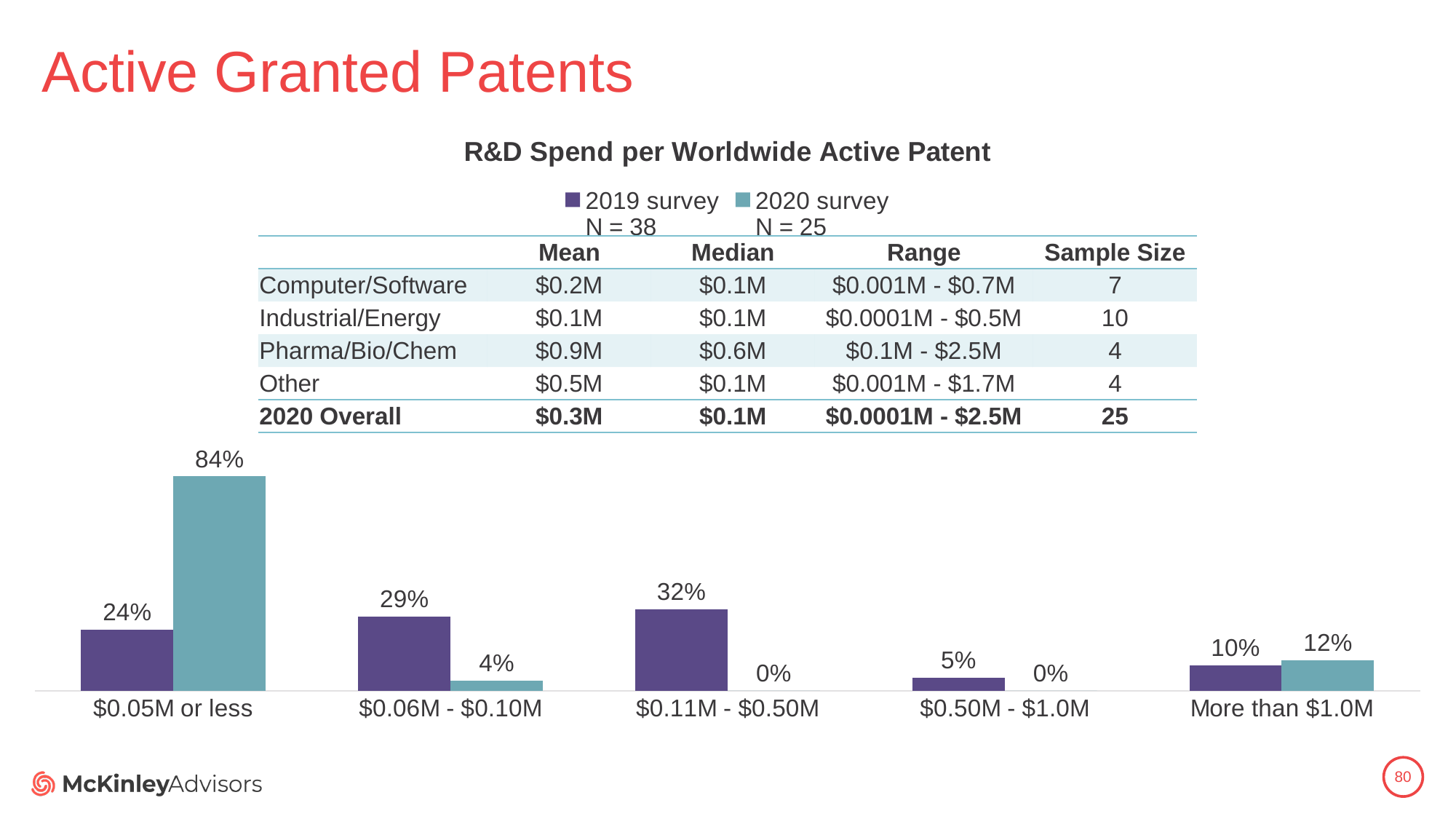
What is the 2020 survey value for the "More than $1.0M" category? 12% Which is larger for the "$0.06M - $0.10M" category: the 2019 survey value or the 2020 survey value? 2019 survey What is the title of the chart? R&D Spend per Worldwide Active Patent Which category has the highest 2019 survey value? $0.11M - $0.50M How many categories are shown on the x axis of the chart? 5 What is the difference between the 2020 survey and 2019 survey values for the "$0.05M or less" category? 60% What is the 2020 survey value for the "$0.05M or less" category? 84% What is the 2019 survey value for the "$0.11M - $0.50M" category? 32% What is the 2019 survey value for the "$0.50M - $1.0M" category? 5% What type of chart is shown on the slide? Bar chart Which category has the lowest 2019 survey value? $0.50M - $1.0M How many series does the chart legend list? 2